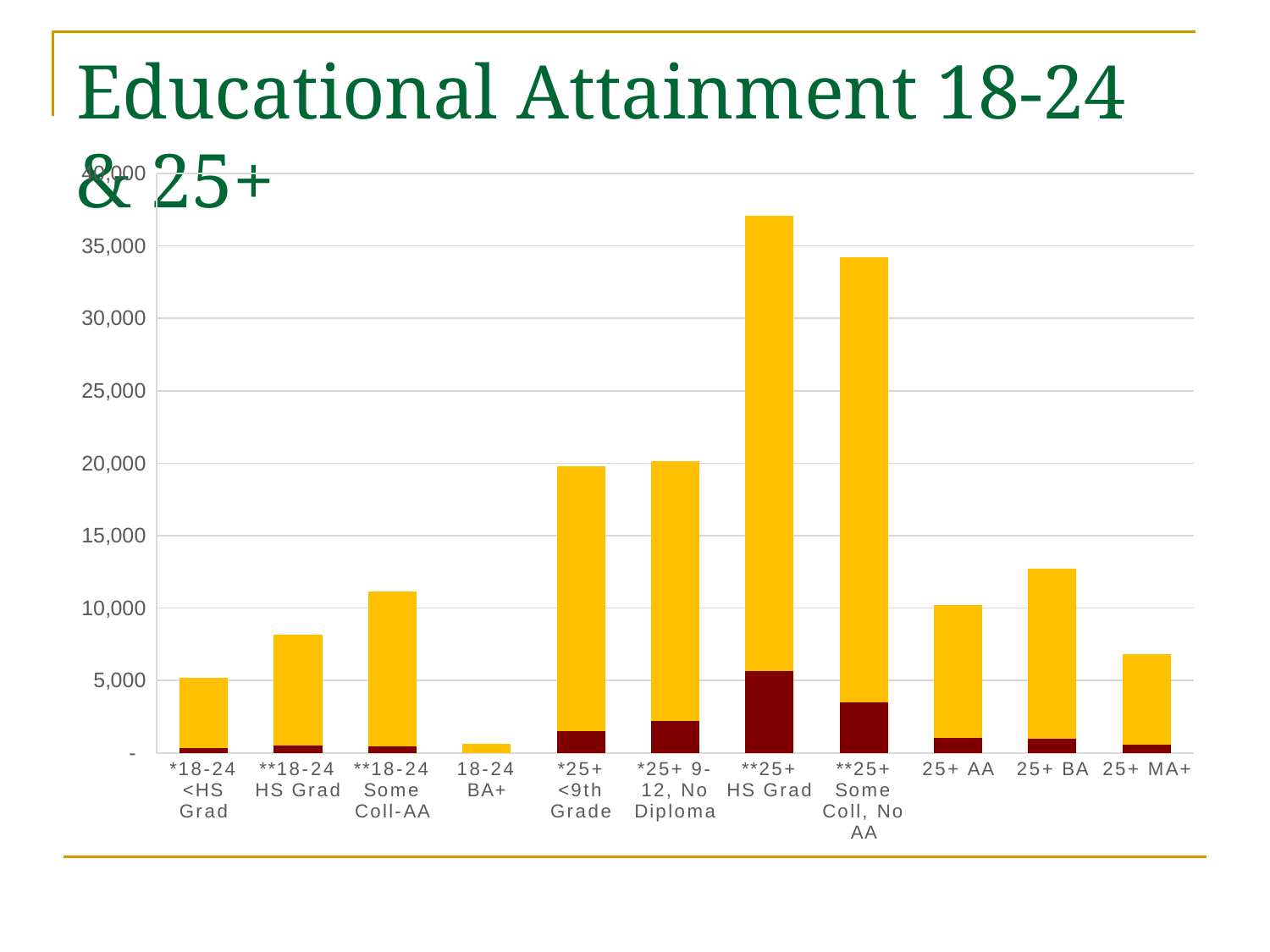
Which category has the tallest bar in the chart? **25+ HS Grad What is the title of the slide containing the chart? Educational Attainment 18-24 & 25+ Which category has the shortest bar in the chart? 18-24 BA+ Which bar is taller, **25+ HS Grad or **25+ Some Coll, No AA? **25+ HS Grad How many categories are shown on the x axis of the chart? 11 Is the total bar for 18-24 BA+ greater or less than 5,000? less What kind of chart is shown on the slide? Stacked bar chart Is the total bar for **25+ HS Grad greater or less than 35,000? greater Which bar is taller, 25+ BA or 25+ AA? 25+ BA Is the total bar for 25+ BA greater or less than 10,000? greater